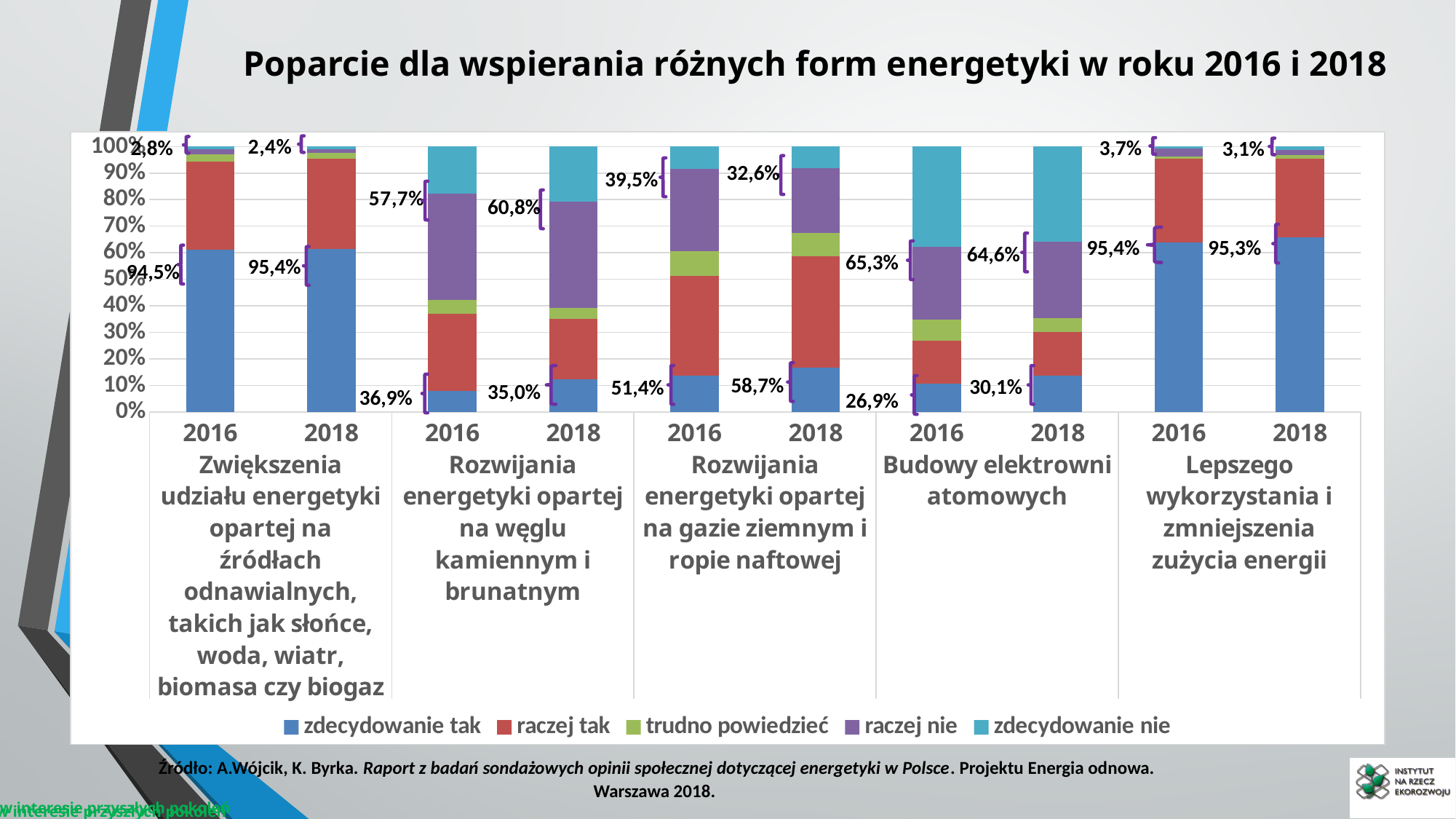
By how many percentage points did combined support for gas and oil energy (Rozwijania energetyki opartej na gazie ziemnym i ropie naftowej) change from 2016 (51,4%) to 2018 (58,7%)? 7,3 percentage points How many bars are plotted on the chart? 10 What combined share of respondents supported ("zdecydowanie tak" + "raczej tak") building nuclear power plants (Budowy elektrowni atomowych) in 2016? 26,9% Was combined support for coal-based energy higher in 2016 or in 2018? 2016 What combined share of respondents opposed developing coal-based energy (Rozwijania energetyki opartej na węglu kamiennym i brunatnym) in 2018? 60,8% Is the "zdecydowanie tak" share for renewable energy in 2016 greater or less than 50%? greater Which energy form and year had the lowest combined support shown on the chart? Budowy elektrowni atomowych, 2016 (26,9%) What combined share supported better use and reduction of energy consumption (Lepszego wykorzystania i zmniejszenia zużycia energii) in 2016? 95,4% What kind of chart is shown on the slide? Stacked bar chart How many series does the legend list? 5 What combined share opposed increasing the share of renewable energy in 2018? 2,4% Which energy form and year had the highest combined opposition shown on the chart? Budowy elektrowni atomowych, 2016 (65,3%)